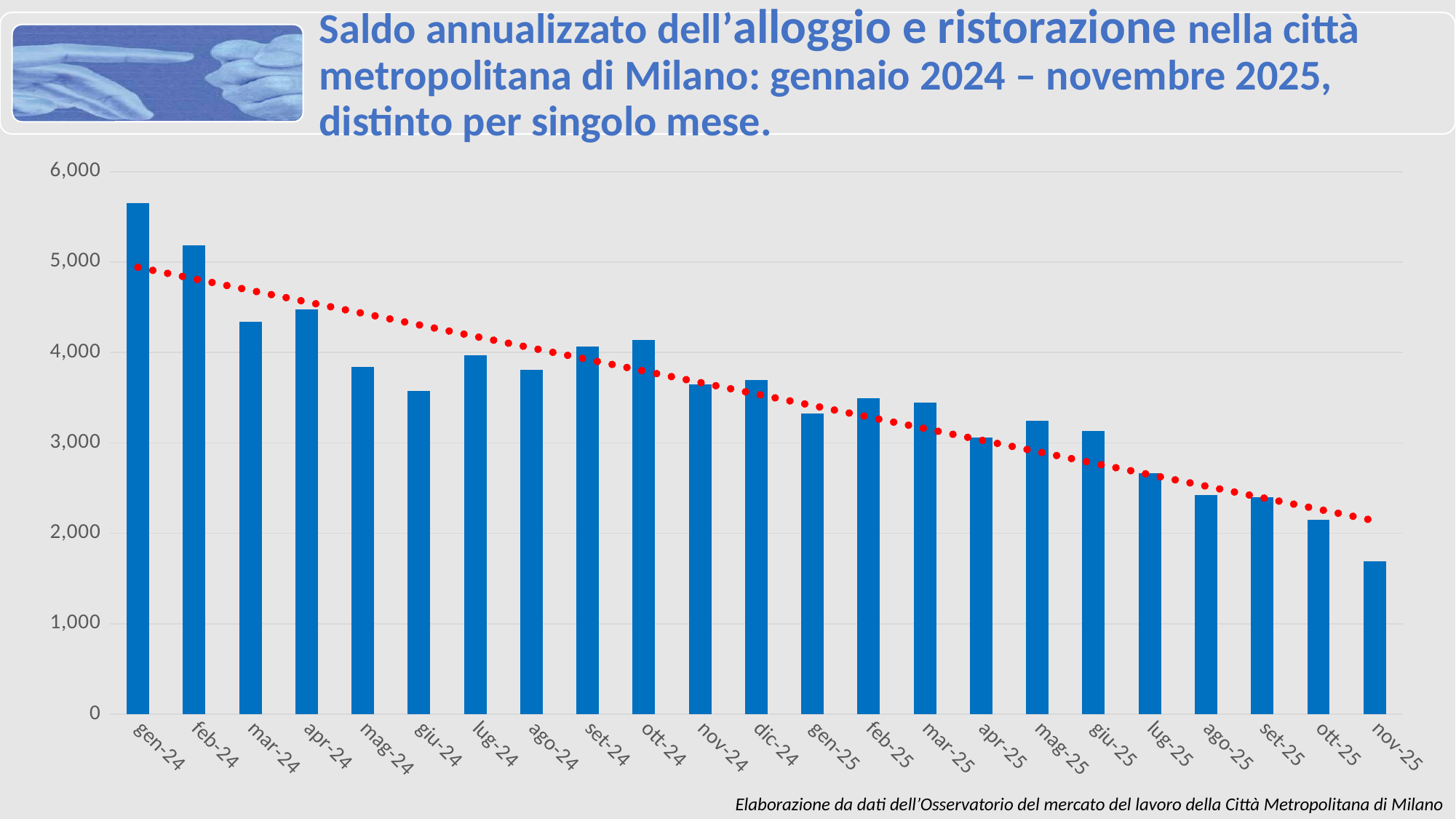
Is the value for giu-24 greater or less than 4,000? less Do the values generally rise or fall from gen-24 to nov-25? fall Is the value for gen-24 greater or less than 5,000? greater What kind of chart is shown on the slide? bar chart Which month has the lowest value? nov-25 Is the value for lug-25 greater or less than 3,000? less What colour is the dotted trend line drawn across the bars? red Which is larger, the value for mar-24 or the value for apr-24? apr-24 Which month has the highest value? gen-24 Which is larger, the value for giu-24 or the value for lug-24? lug-24 How many months (bars) are plotted on the chart? 23